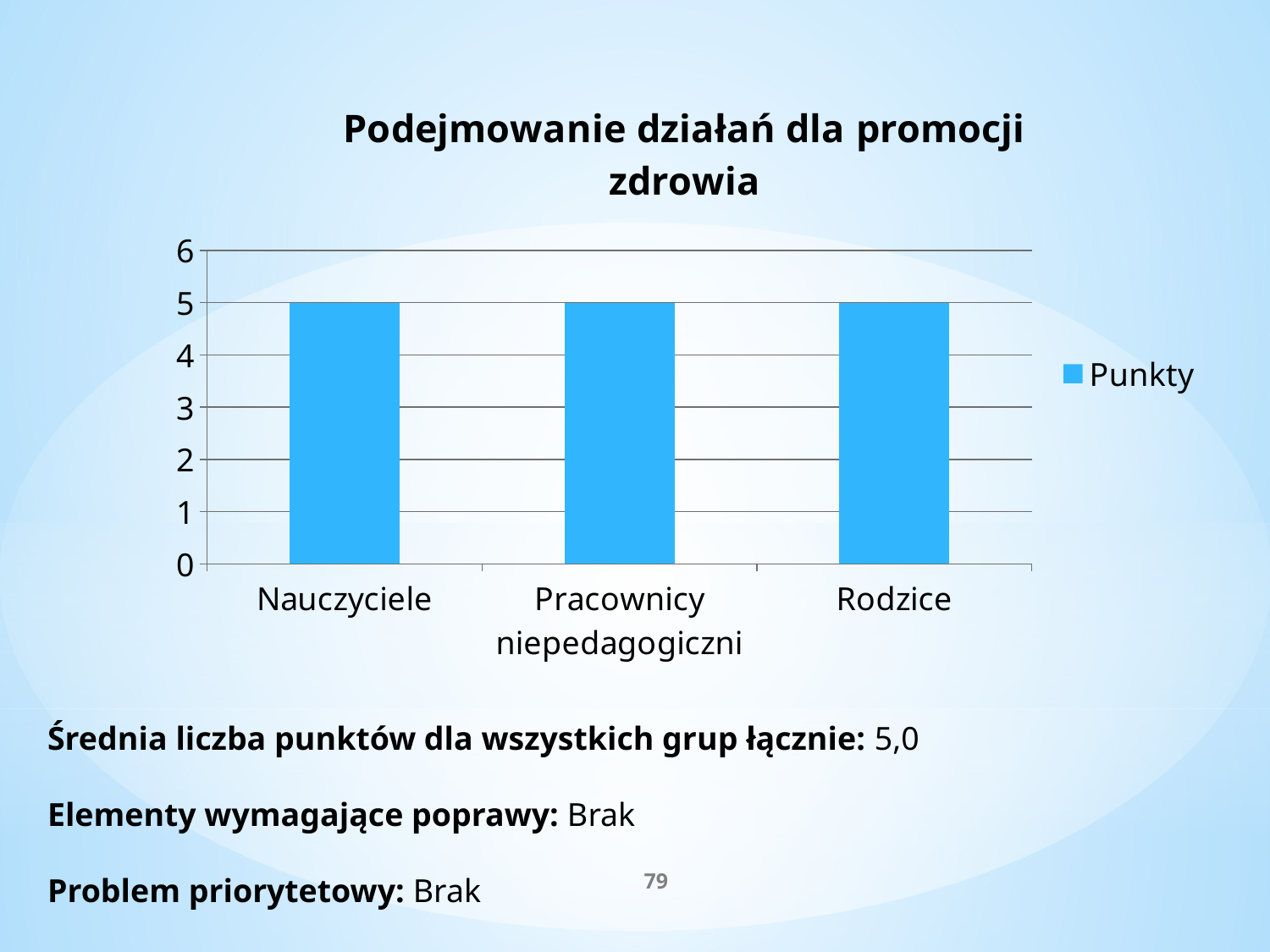
What is the title of the chart? Podejmowanie działań dla promocji zdrowia How many series does the chart legend list? 1 How many categories are shown on the x axis of the chart? 3 What type of chart is shown on the slide? bar chart What is the value for Nauczyciele? 5 What is the value for Rodzice? 5 What is the difference between the values for Nauczyciele and Rodzice? 0 What is the value for Pracownicy niepedagogiczni? 5 What is the name of the series shown in the legend? Punkty Is the value for Rodzice greater or less than 4? greater Is the value for Nauczyciele greater or less than 6? less Do the values rise, fall or stay the same across the categories from left to right? stay the same